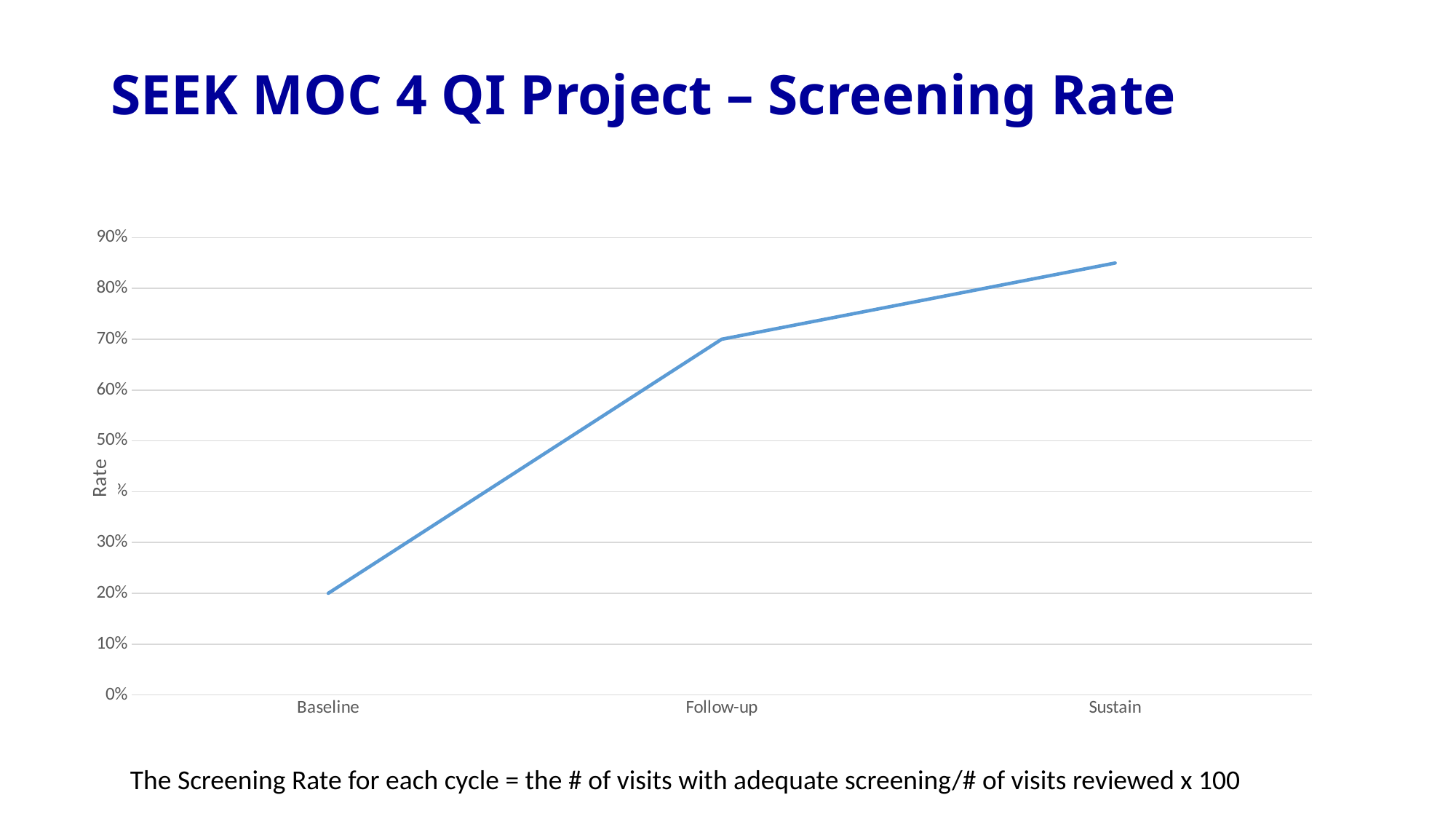
What kind of chart is shown on the slide? line chart What is the label on the vertical axis? Rate What is the difference between the Follow-up and Baseline screening rates? 50% What is the screening rate at Follow-up? 70% How many points are plotted on the line? 3 Which is larger, the screening rate at Follow-up or at Sustain? Sustain Which cycle has the highest screening rate? Sustain Do the values rise or fall from Baseline to Sustain? rise Is the value for Sustain greater or less than 80%? greater Which cycle has the lowest screening rate? Baseline Is the value for Sustain greater or less than 90%? less What is the screening rate at Baseline? 20%